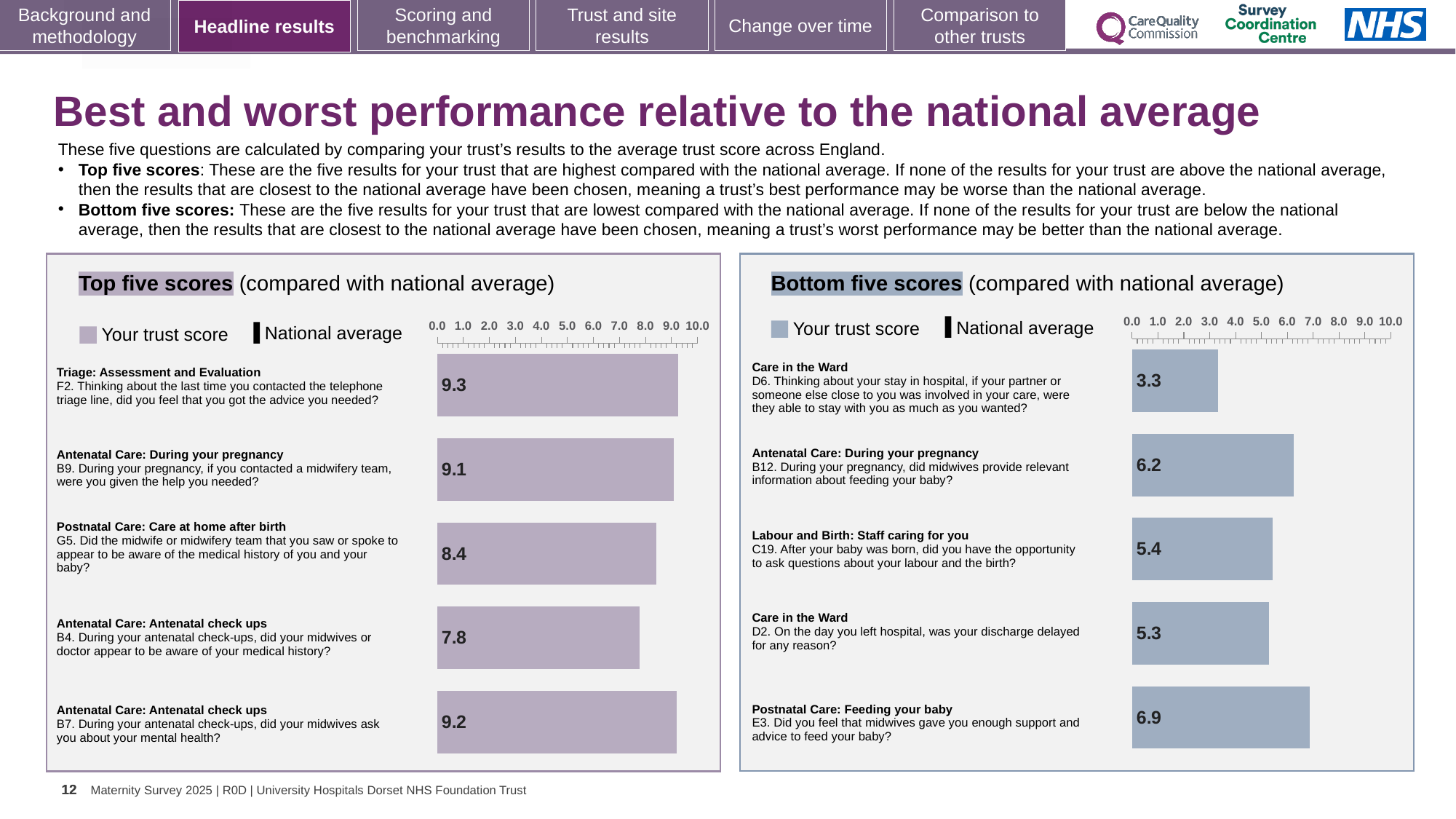
In the Bottom five scores chart, what is the trust score for D6 (was your partner or someone close able to stay with you as much as you wanted)? 3.3 In the Top five scores chart, which question has the lowest trust score? B4 (antenatal check-ups, aware of medical history), 7.8 In the Top five scores chart, what is the trust score for F2 (did you feel you got the advice you needed from the telephone triage line)? 9.3 In the Bottom five scores chart, which has the larger trust score: C19 (opportunity to ask questions about labour and birth) or D2 (discharge delayed)? C19 In the Bottom five scores chart, which question has the lowest trust score? D6 (partner able to stay with you), 3.3 In the Top five scores chart, what is the difference between the trust scores for F2 (9.3) and B4 (7.8)? 1.5 In the Bottom five scores chart, is the trust score for B12 (information about feeding your baby) greater or less than 5.0? greater In the Top five scores chart, which question has the highest trust score? F2 (telephone triage advice), 9.3 What type of chart is used in the Bottom five scores panel? Bar chart How many questions are plotted in the Top five scores chart? 5 In the Bottom five scores chart, what is the difference between the trust scores for E3 and D6? 3.6 In the Bottom five scores chart, which question has the highest trust score? E3 (support and advice to feed your baby), 6.9